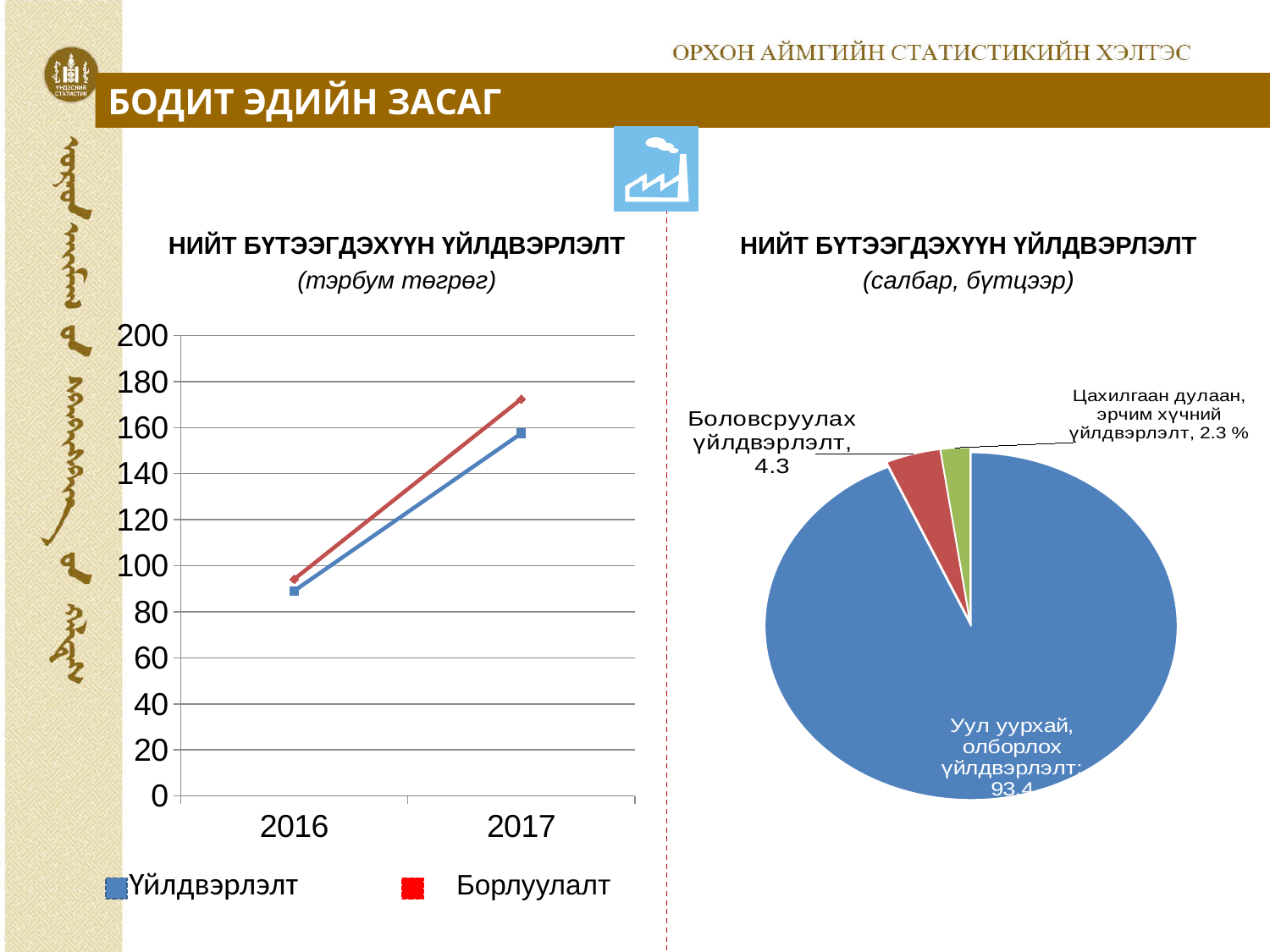
In the right pie chart, what is the value shown for Уул уурхай, олборлох үйлдвэрлэлт? 93.4 What kind of chart is the right chart titled 'НИЙТ БҮТЭЭГДЭХҮҮН ҮЙЛДВЭРЛЭЛТ (салбар, бүтцээр)'? pie chart In the left line chart, how many series does the legend list? 2 In the left line chart, is the value for Борлуулалт in 2017 greater or less than 160? greater In the left line chart, is the value for Үйлдвэрлэлт in 2016 greater or less than 100? less In the right pie chart, which slice is the smallest? Цахилгаан дулаан, эрчим хүчний үйлдвэрлэлт In the left line chart, does the value for Үйлдвэрлэлт rise or fall from 2016 to 2017? rise In the right pie chart, what is the value shown for Боловсруулах үйлдвэрлэлт? 4.3 What kind of chart is the left chart titled 'НИЙТ БҮТЭЭГДЭХҮҮН ҮЙЛДВЭРЛЭЛТ (тэрбум төгрөг)'? line chart In the left line chart, which series has the higher value in 2017, Үйлдвэрлэлт or Борлуулалт? Борлуулалт In the left line chart, how many years are shown on the x axis? 2 In the right pie chart, what is the value shown for Цахилгаан дулаан, эрчим хүчний үйлдвэрлэлт? 2.3 %